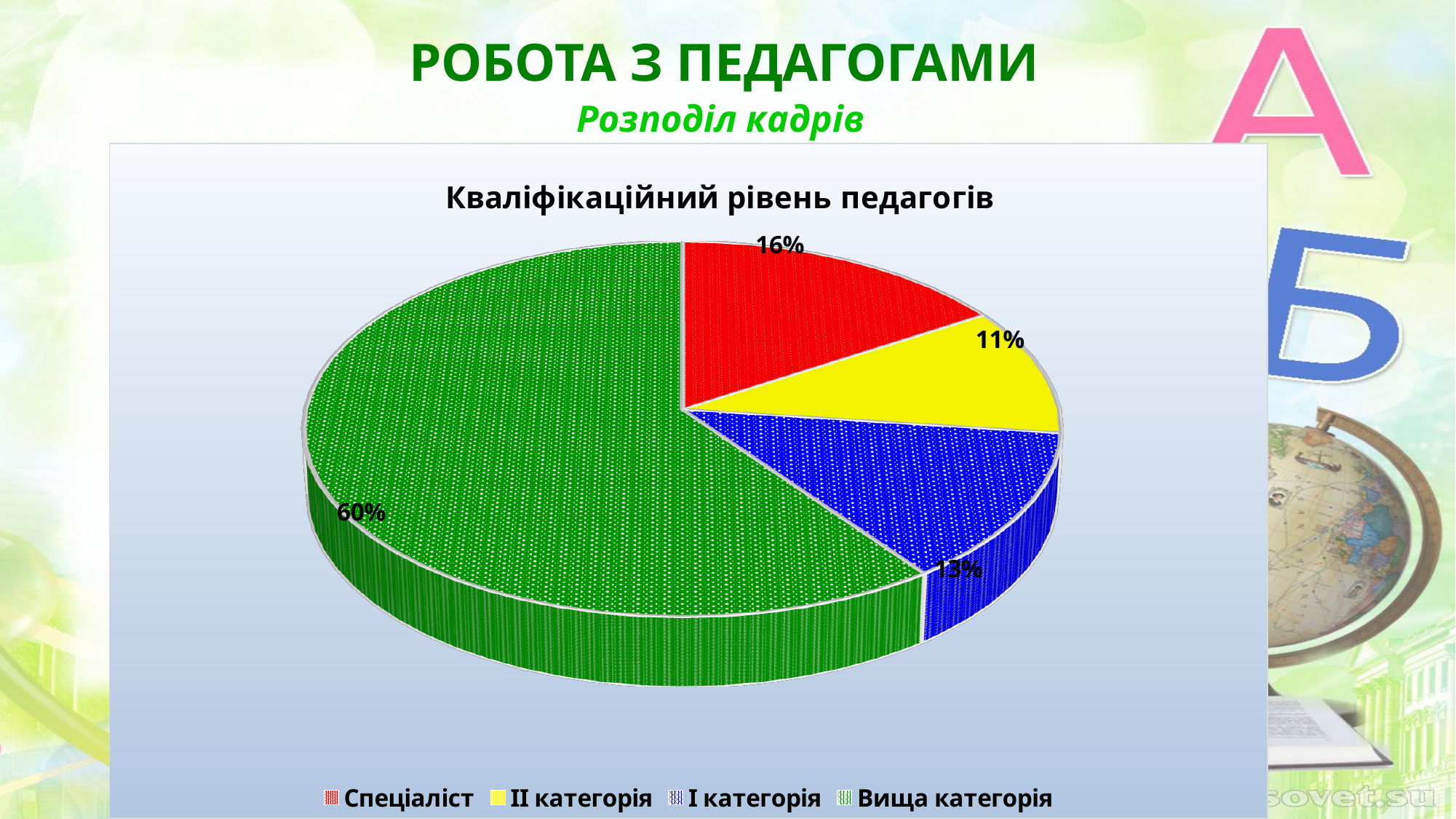
How many categories does the legend list? 4 What type of chart is shown on the slide? Pie chart What percentage of the pie is labelled for I категорія? 13% What is the title of the chart? Кваліфікаційний рівень педагогів Which is larger, the share for Спеціаліст or the share for I категорія? Спеціаліст What colour is the slice for Вища категорія? Green What percentage of the pie is labelled for II категорія? 11% What percentage of the pie is labelled for Вища категорія? 60% Which category has the largest share of the pie? Вища категорія Which category has the smallest share of the pie? II категорія What is the difference in percentage points between Вища категорія and Спеціаліст? 44 What percentage of the pie is labelled for Спеціаліст? 16%